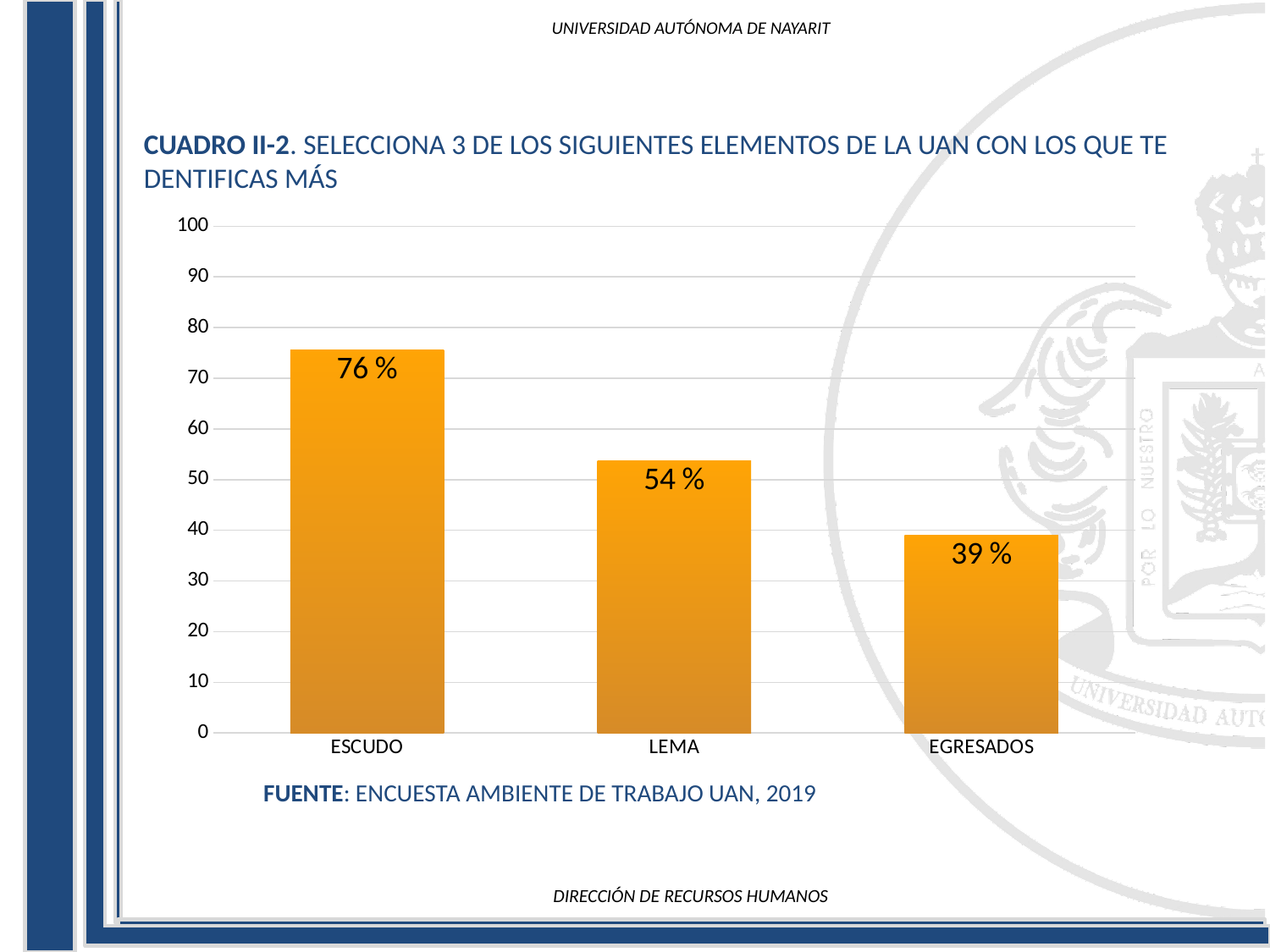
Which is larger, the value for LEMA or the value for EGRESADOS? LEMA What is the difference between the values for LEMA and EGRESADOS? 15 % What is the value for LEMA? 54 % How many categories are shown on the x axis? 3 Do the values rise or fall from left to right along the x axis? fall What is the difference between the values for ESCUDO and LEMA? 22 % Is the value for EGRESADOS greater or less than 50? less What is the value for EGRESADOS? 39 % What is the value for ESCUDO? 76 % What kind of chart is shown on the slide? bar chart Which category has the lowest value? EGRESADOS Which category has the highest value? ESCUDO